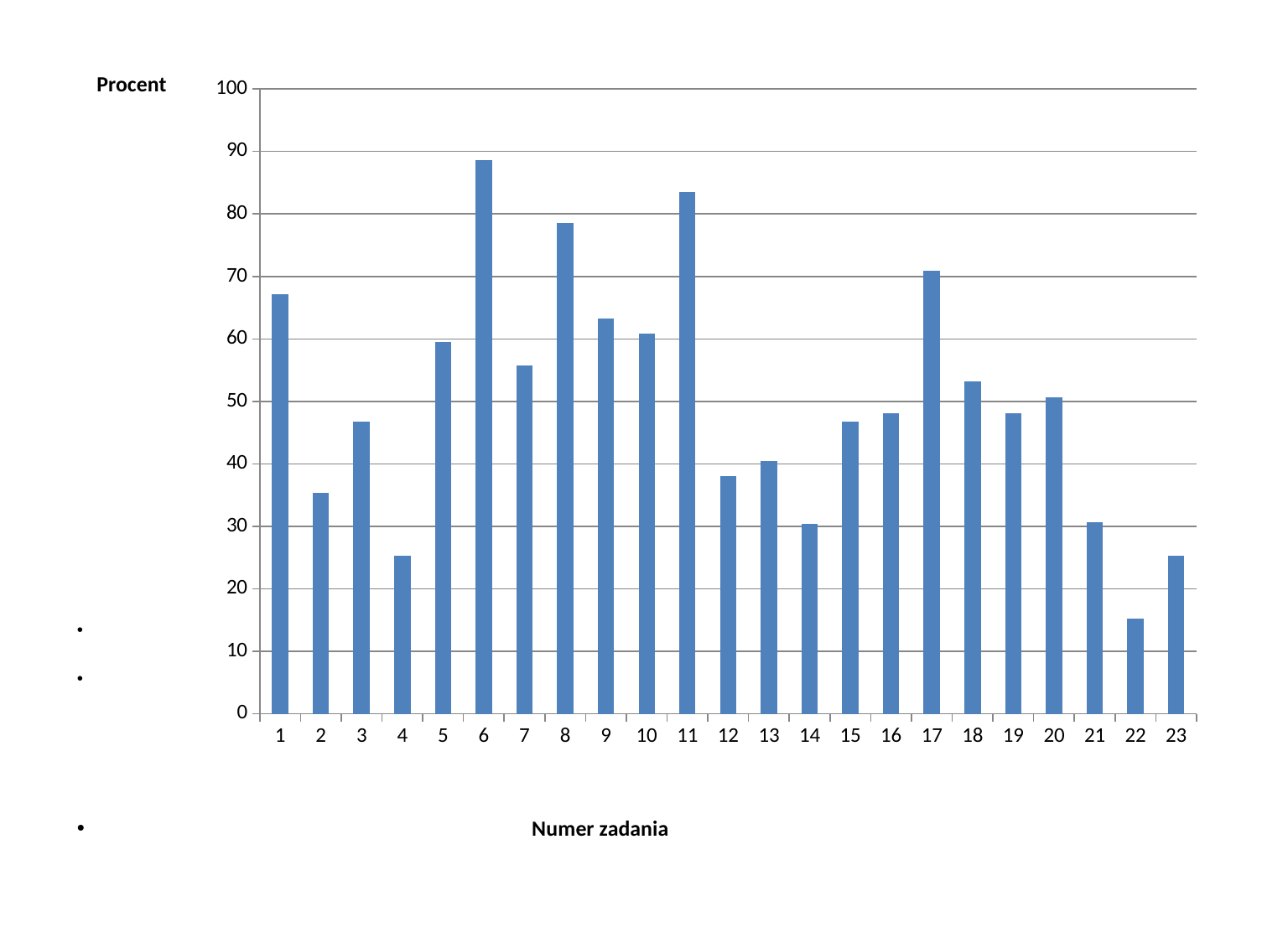
Which task number has the highest percentage? 6 Which has a higher value, task 8 or task 17? task 8 What type of chart is shown on the slide? bar chart Is the value for task 1 greater or less than 70? less Is the value for task 22 greater or less than 20? less Is the value for task 11 greater or less than 80? greater Which task number has the lowest percentage? 22 Which has a higher value, task 6 or task 11? task 6 How many tasks (numer zadania) are plotted on the x axis? 23 What is the label of the vertical axis? Procent